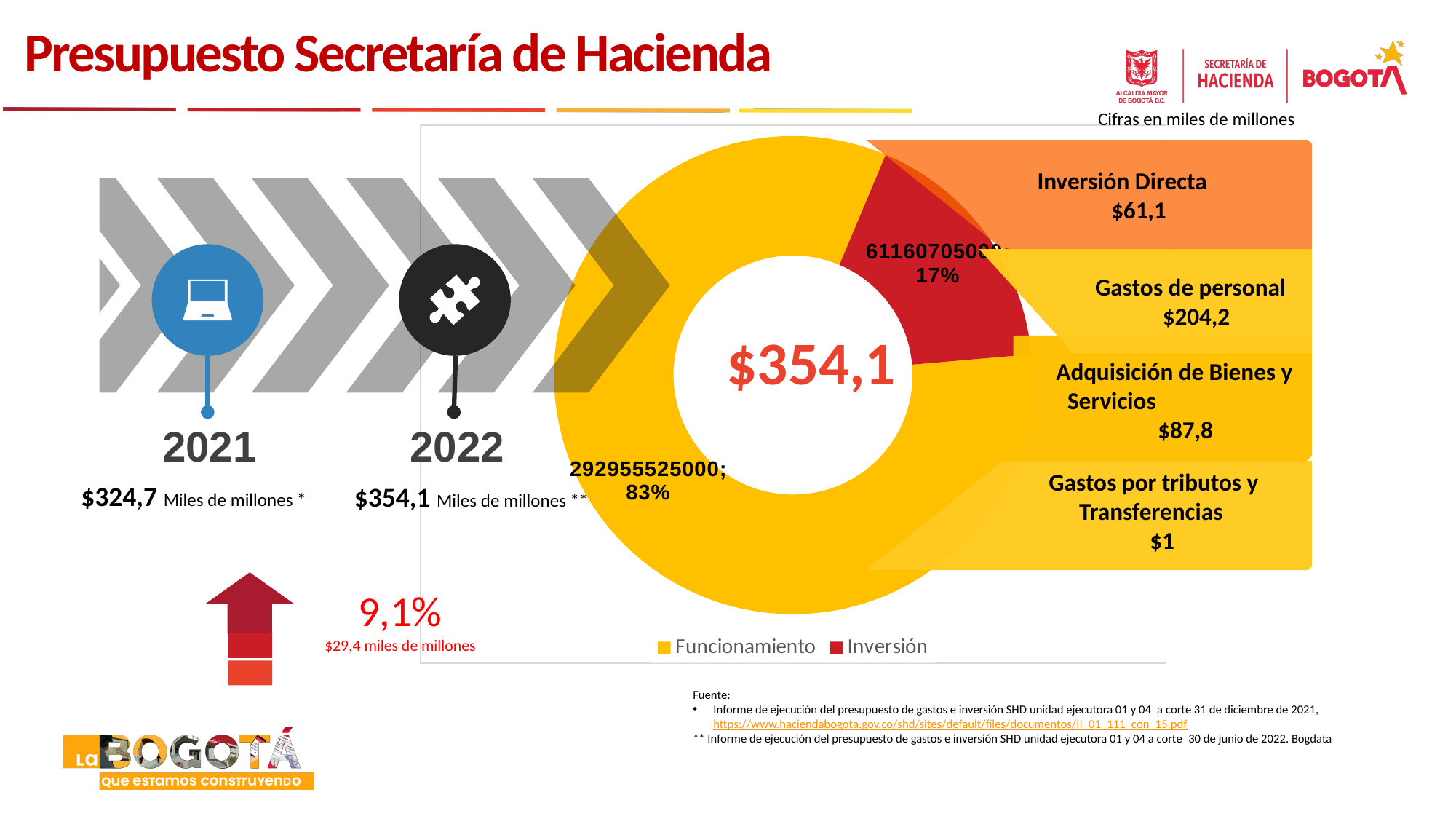
What are the two legend entries of the donut chart? Funcionamiento and Inversión What value is printed in the centre of the donut chart? $354,1 What percentage share of the donut chart does Funcionamiento represent? 83% What is the difference in percentage points between the Funcionamiento and Inversión shares in the donut chart? 66 percentage points How many series does the legend of the donut chart list? 2 Which slice of the donut chart is the smallest? Inversión What percentage share of the donut chart does Inversión represent? 17% Which is larger in the donut chart, Funcionamiento or Inversión? Funcionamiento Which slice of the donut chart is the largest? Funcionamiento What kind of chart is shown on the slide? Pie chart (donut) How many slices does the donut chart have? 2 What is the value printed for the Funcionamiento slice of the donut chart? 292955525000